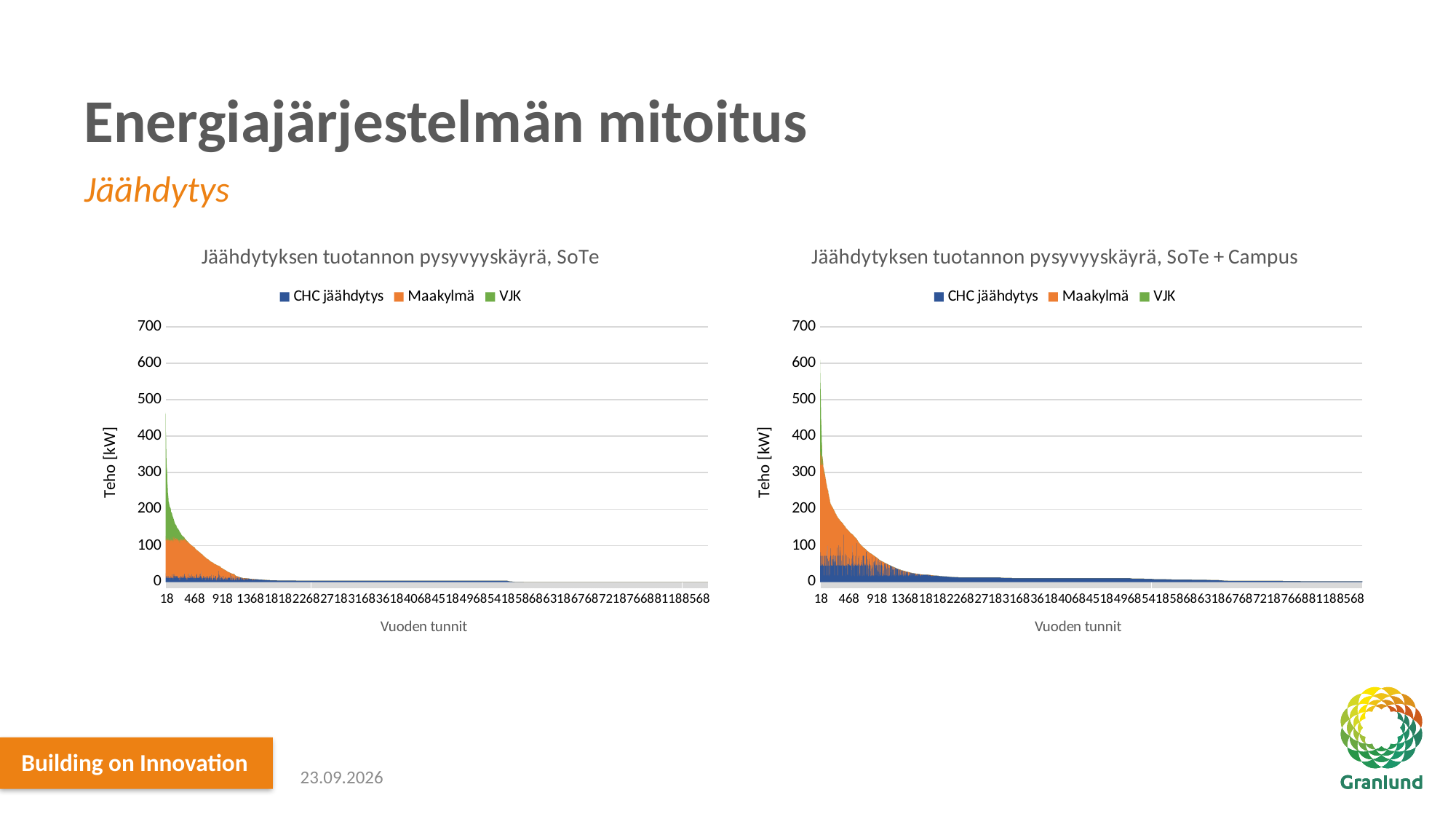
How many series does the legend list in the chart titled "Jäähdytyksen tuotannon pysyvyyskäyrä, SoTe + Campus"? 3 What is the y-axis label of the left chart (SoTe)? Teho [kW] In the left chart (SoTe), do the plotted values rise or fall as you move along the x axis? fall In the right chart (SoTe + Campus), do the plotted values rise or fall as you move along the x axis? fall In the left chart (SoTe), is the highest stacked value greater or less than 300? greater Which series is shown in green in the right chart (SoTe + Campus)? VJK In the left chart (SoTe), is the highest stacked value greater or less than 500? less In the right chart (SoTe + Campus), is the highest stacked value greater or less than 500? greater How many series does the legend list in the chart titled "Jäähdytyksen tuotannon pysyvyyskäyrä, SoTe"? 3